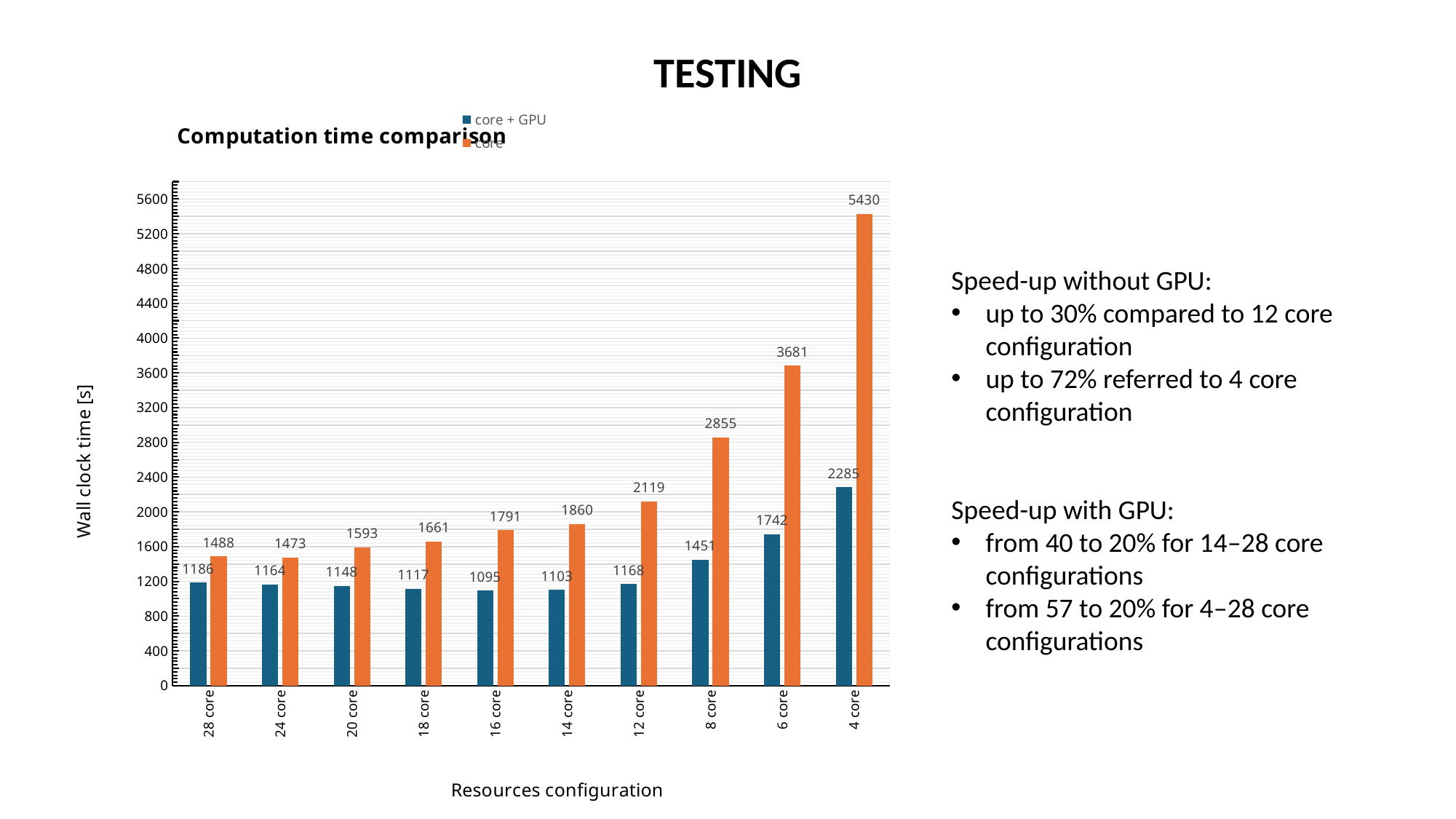
Which is larger at the 6 core configuration: the core value or the core + GPU value? core What is the difference between the core and core + GPU wall clock times at the 8 core configuration? 1404 What is the title of the chart? Computation time comparison What is the wall clock time for the core + GPU series at the 16 core configuration? 1095 What is the wall clock time for the core series at the 12 core configuration? 2119 How many series does the legend list? 2 Which configuration has the lowest wall clock time for the core + GPU series? 16 core How many resource configurations are shown on the x axis? 10 What kind of chart is shown on the slide? bar chart What is the wall clock time for the core series at the 4 core configuration? 5430 Does the core series wall clock time rise or fall moving from 28 core to 4 core along the x axis? rise Which configuration has the highest wall clock time for the core series? 4 core